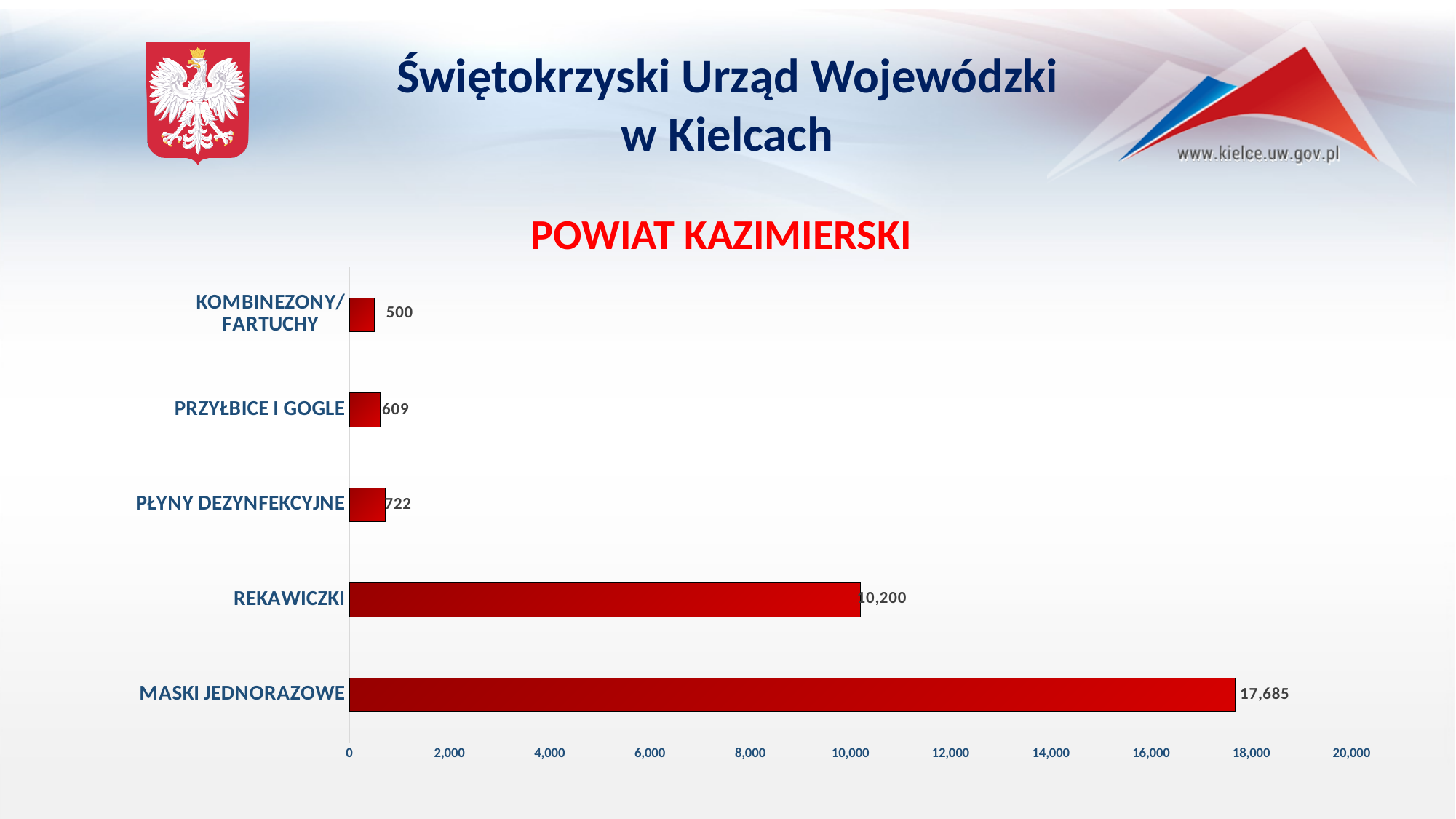
Which is larger, the value for PŁYNY DEZYNFEKCYJNE or PRZYŁBICE I GOGLE? PŁYNY DEZYNFEKCYJNE Which category has the lowest value? KOMBINEZONY/FARTUCHY What is the difference between the values for MASKI JEDNORAZOWE and REKAWICZKI? 7,485 What is the value for REKAWICZKI? 10,200 Which category has the highest value? MASKI JEDNORAZOWE What is the value for MASKI JEDNORAZOWE? 17,685 What is the value for KOMBINEZONY/FARTUCHY? 500 How many categories are shown in the chart? 5 What is the value for PRZYŁBICE I GOGLE? 609 What is the value for PŁYNY DEZYNFEKCYJNE? 722 Is the value for REKAWICZKI greater or less than 12,000? less What kind of chart is shown on the slide? bar chart